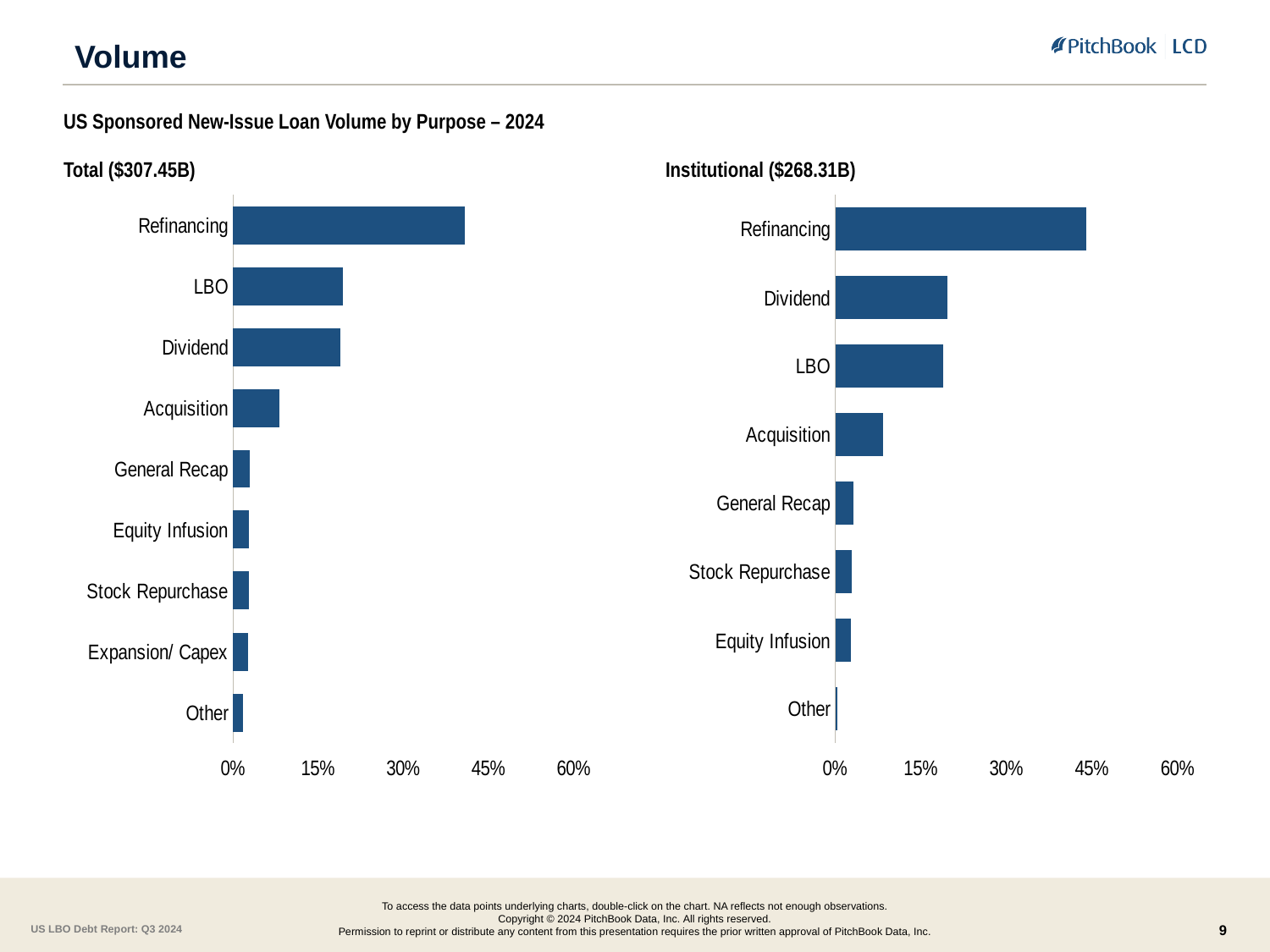
In the Total ($307.45B) chart, how many purpose categories are plotted? 9 In the Total ($307.45B) chart, which is larger, the value for LBO or the value for Acquisition? LBO In the Institutional ($268.31B) chart, is the value for Acquisition greater or less than 15%? less In the Total ($307.45B) chart, which category has the lowest share? Other In the Total ($307.45B) chart, which category has the highest share? Refinancing In the Total ($307.45B) chart, what kind of chart is shown? bar chart In the Institutional ($268.31B) chart, which is larger, the value for Dividend or the value for General Recap? Dividend In the Institutional ($268.31B) chart, which category has the lowest share? Other What is the overall title shown above the two charts? US Sponsored New-Issue Loan Volume by Purpose – 2024 In the Institutional ($268.31B) chart, how many purpose categories are plotted? 8 In the Total ($307.45B) chart, is the value for Refinancing greater or less than 30%? greater